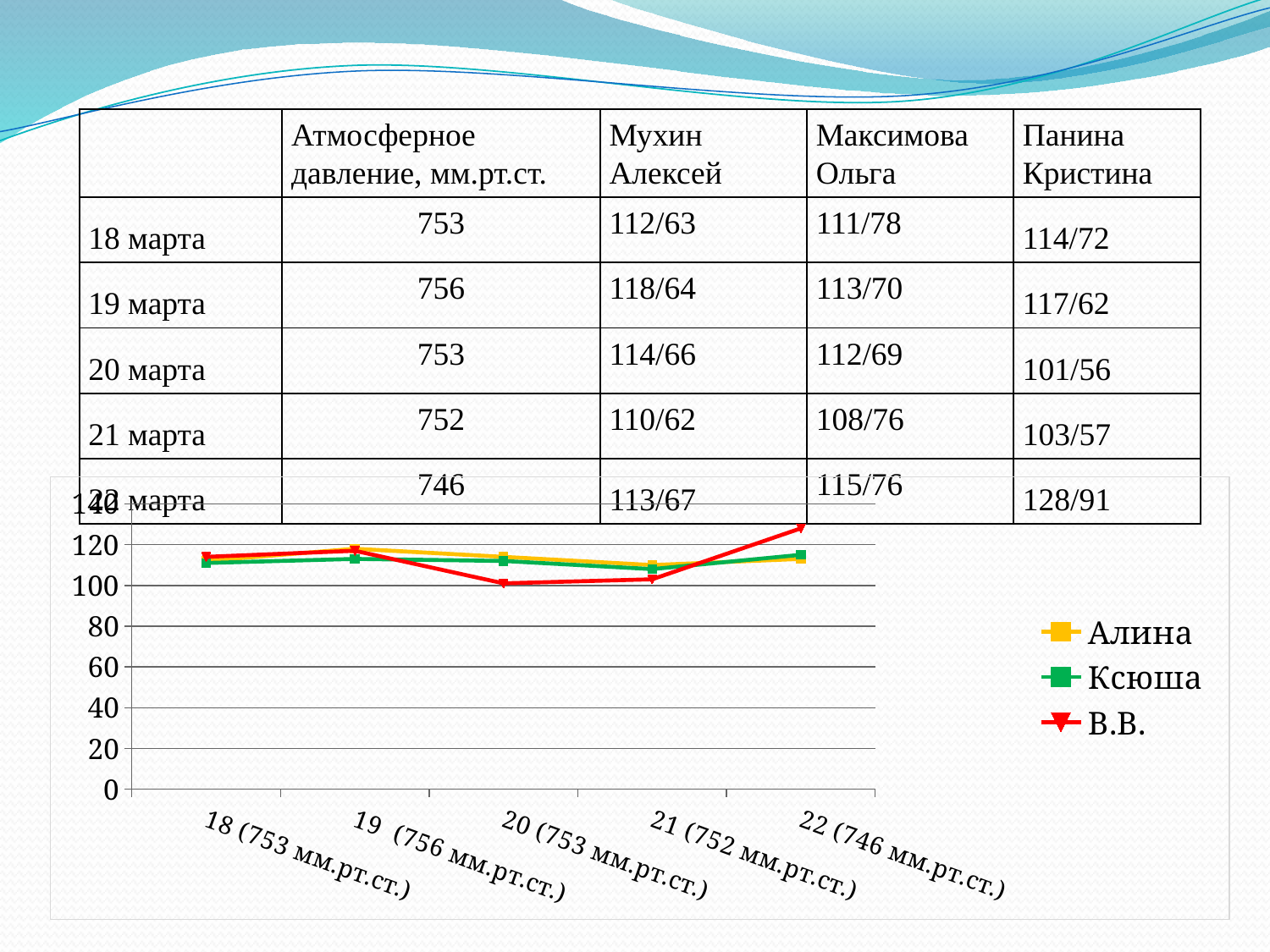
Is the value for В.В. at 22 (746 мм.рт.ст.) greater or less than 120? greater Is the value for Алина at 18 (753 мм.рт.ст.) greater or less than 100? greater Which series has the highest value at 22 (746 мм.рт.ст.)? В.В. At which category does the В.В. series reach its highest value? 22 (746 мм.рт.ст.) Does the В.В. line rise or fall from 21 (752 мм.рт.ст.) to 22 (746 мм.рт.ст.)? rise What colour is the line for В.В. in the chart? red How many series does the chart legend list? 3 Which series has the lowest value at 20 (753 мм.рт.ст.)? В.В. How many categories are plotted along the x axis of the chart? 5 Is the value for В.В. at 20 (753 мм.рт.ст.) greater or less than 120? less What are the three series named in the chart legend? Алина, Ксюша, В.В. What kind of chart is shown on the slide? line chart